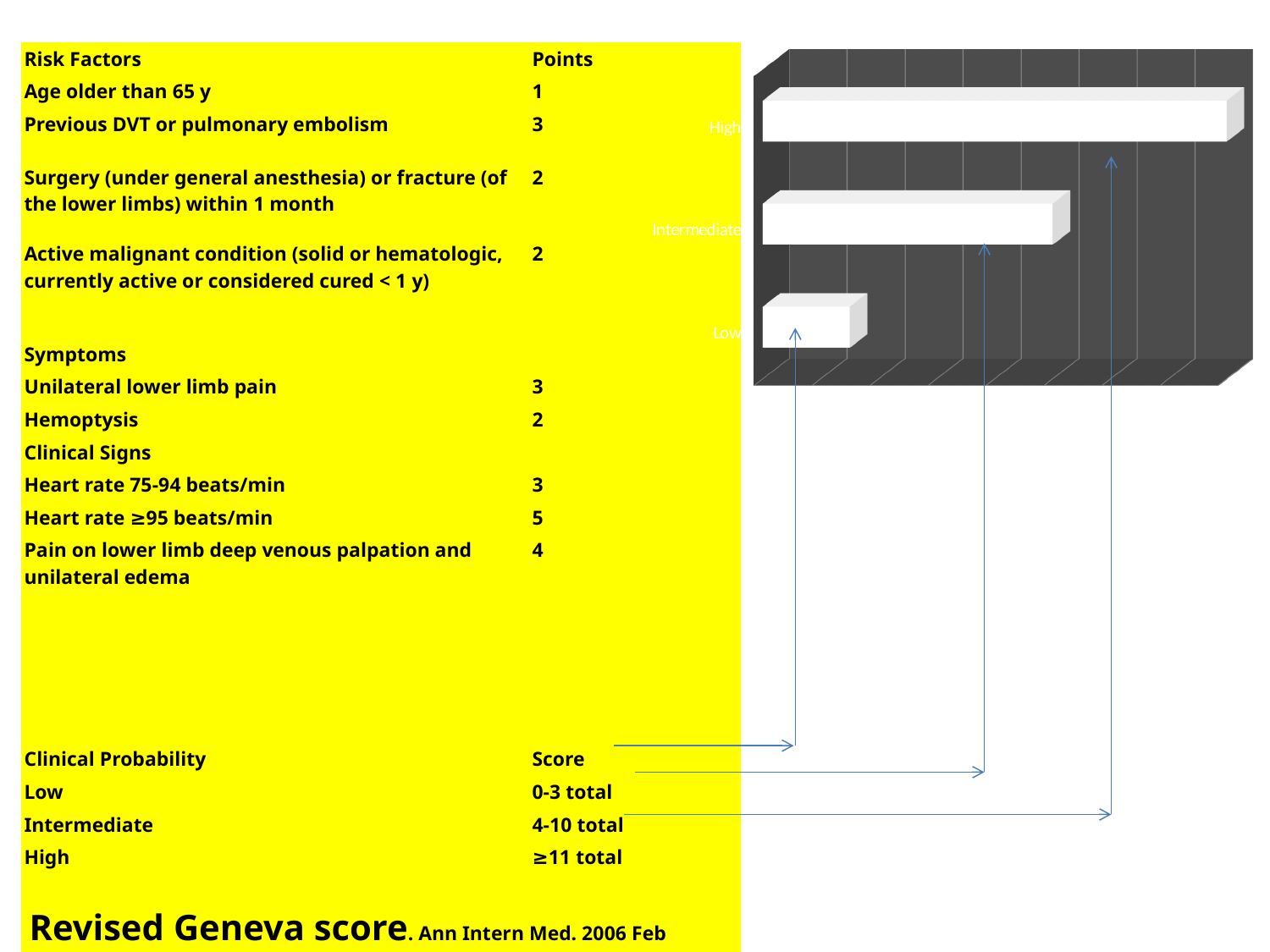
What kind of chart is shown on the right side of the slide? bar chart Which bar is longer, Intermediate or Low? Intermediate Are the bars in the chart horizontal or vertical? horizontal Which bar is longer, High or Intermediate? High What are the three category labels on the chart's vertical axis, from top to bottom? High, Intermediate, Low How many categories does the bar chart show? 3 Which category has the longest bar in the chart? High Which category has the shortest bar in the chart? Low